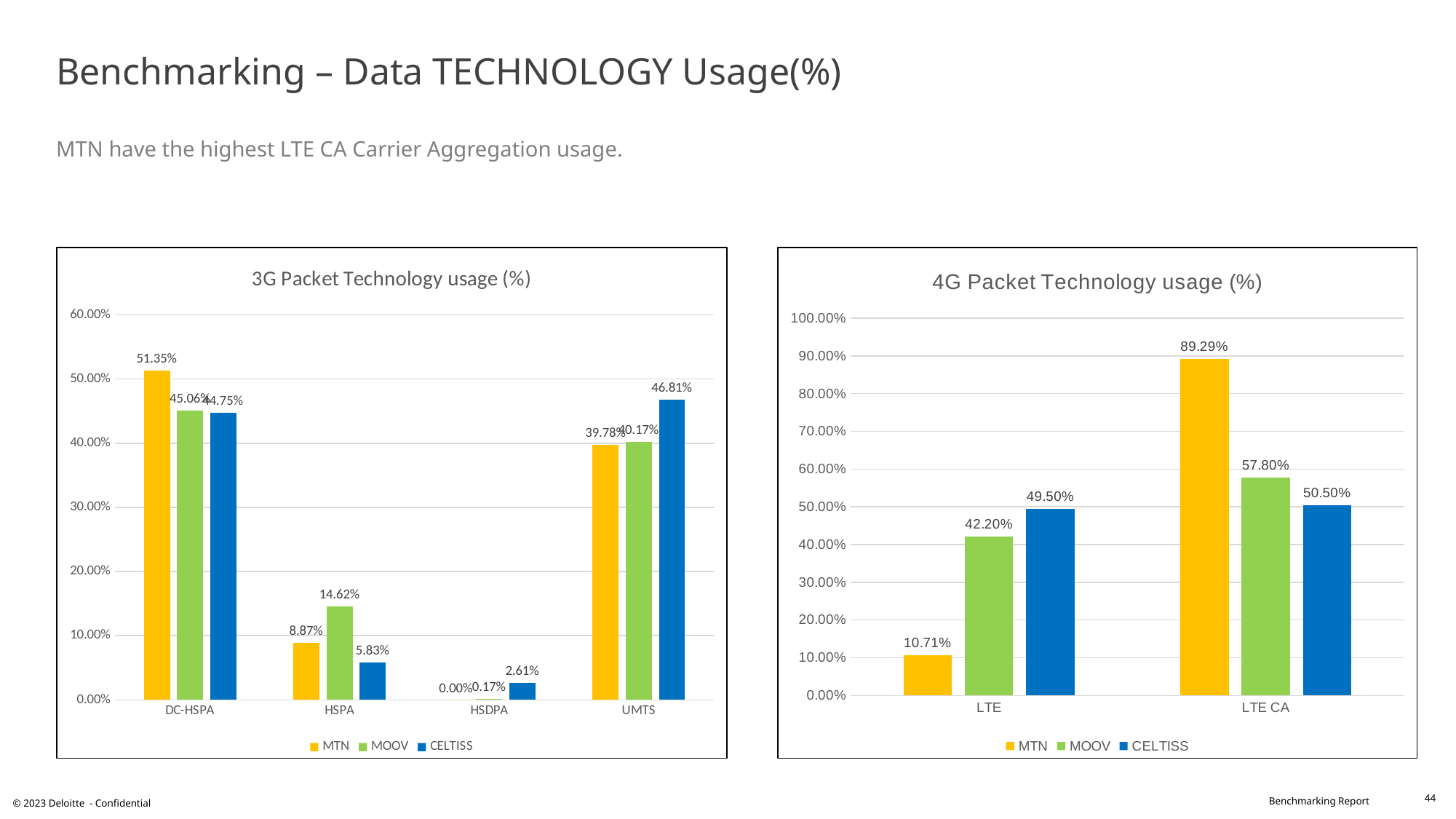
In the 3G Packet Technology usage (%) chart, which category has the highest MTN value? DC-HSPA In the 3G Packet Technology usage (%) chart, what is the value for MTN in the DC-HSPA category? 51.35% In the 3G Packet Technology usage (%) chart, for UMTS, which is larger: the CELTISS value or the MTN value? CELTISS In the 4G Packet Technology usage (%) chart, what is the value for CELTISS in the LTE category? 49.50% In the 4G Packet Technology usage (%) chart, which operator has the highest value for LTE CA? MTN How many categories are shown on the x axis of the 3G Packet Technology usage (%) chart? 4 In the 3G Packet Technology usage (%) chart, what is the value for CELTISS in the HSDPA category? 2.61% In the 4G Packet Technology usage (%) chart, which operator has the lowest value for LTE? MTN How many series does the legend of the 4G Packet Technology usage (%) chart list? 3 In the 4G Packet Technology usage (%) chart, what is the difference between MTN's LTE CA value and MTN's LTE value? 78.58% In the 4G Packet Technology usage (%) chart, what is the value for MTN in the LTE CA category? 89.29% In the 3G Packet Technology usage (%) chart, what is the value for MOOV in the HSPA category? 14.62%